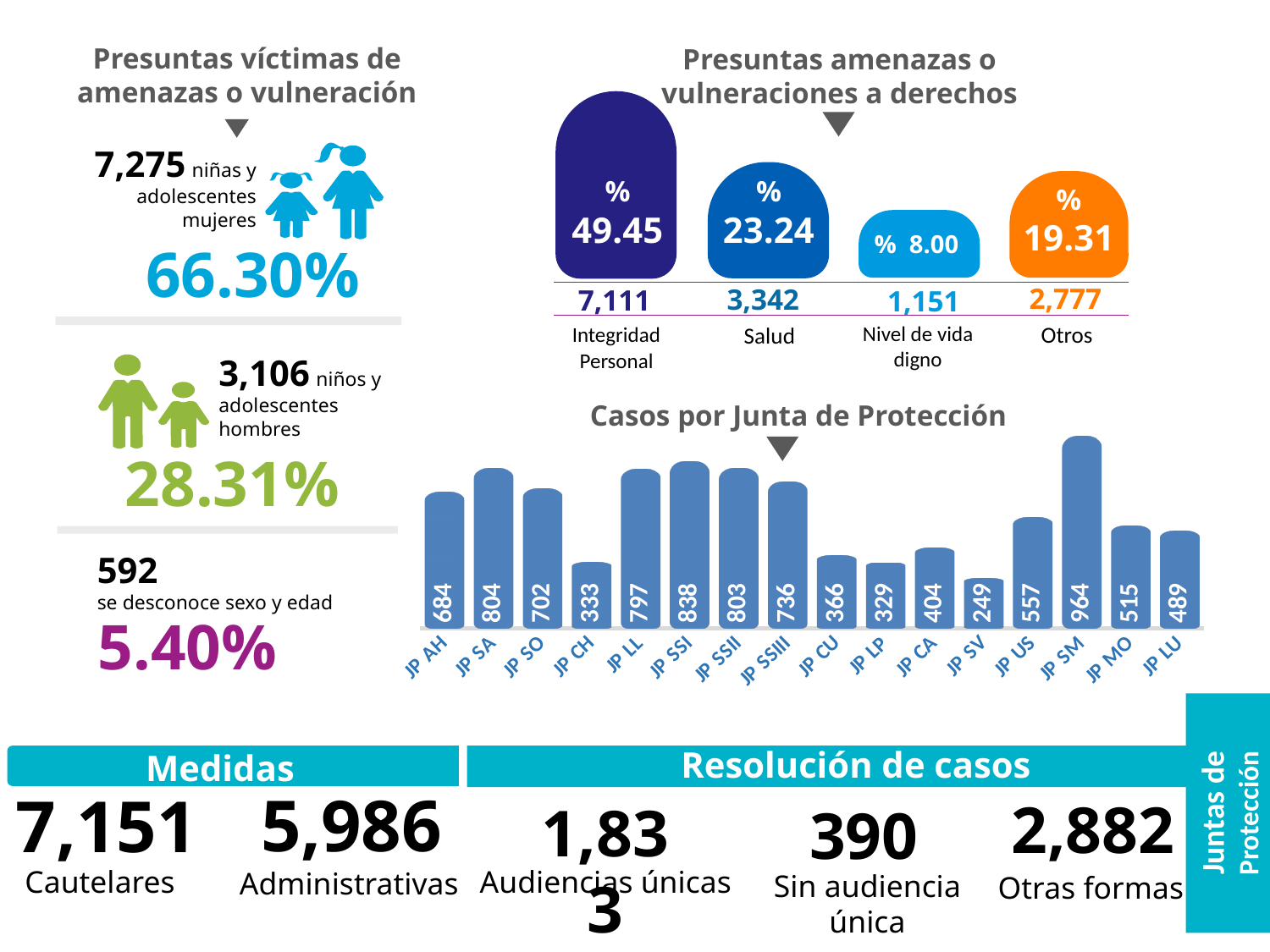
In the 'Casos por Junta de Protección' chart, which is larger, the value for JP CH or the value for JP CU? JP CU What kind of chart is 'Casos por Junta de Protección'? bar chart In the 'Casos por Junta de Protección' chart, what is the value for JP AH? 684 How many Juntas de Protección are shown in the 'Casos por Junta de Protección' chart? 16 In the 'Casos por Junta de Protección' chart, which is larger, the value for JP US or the value for JP MO? JP US In the 'Casos por Junta de Protección' chart, what is the value for JP SSIII? 736 In the 'Casos por Junta de Protección' chart, what is the difference between the values for JP SSI and JP SA? 34 What is the title of the bar chart on the slide? Casos por Junta de Protección In the 'Casos por Junta de Protección' chart, what is the difference between the values for JP SM and JP SV? 715 In the 'Casos por Junta de Protección' chart, what is the value for JP LU? 489 In the 'Casos por Junta de Protección' chart, which Junta has the highest number of cases? JP SM In the 'Casos por Junta de Protección' chart, which Junta has the lowest number of cases? JP SV